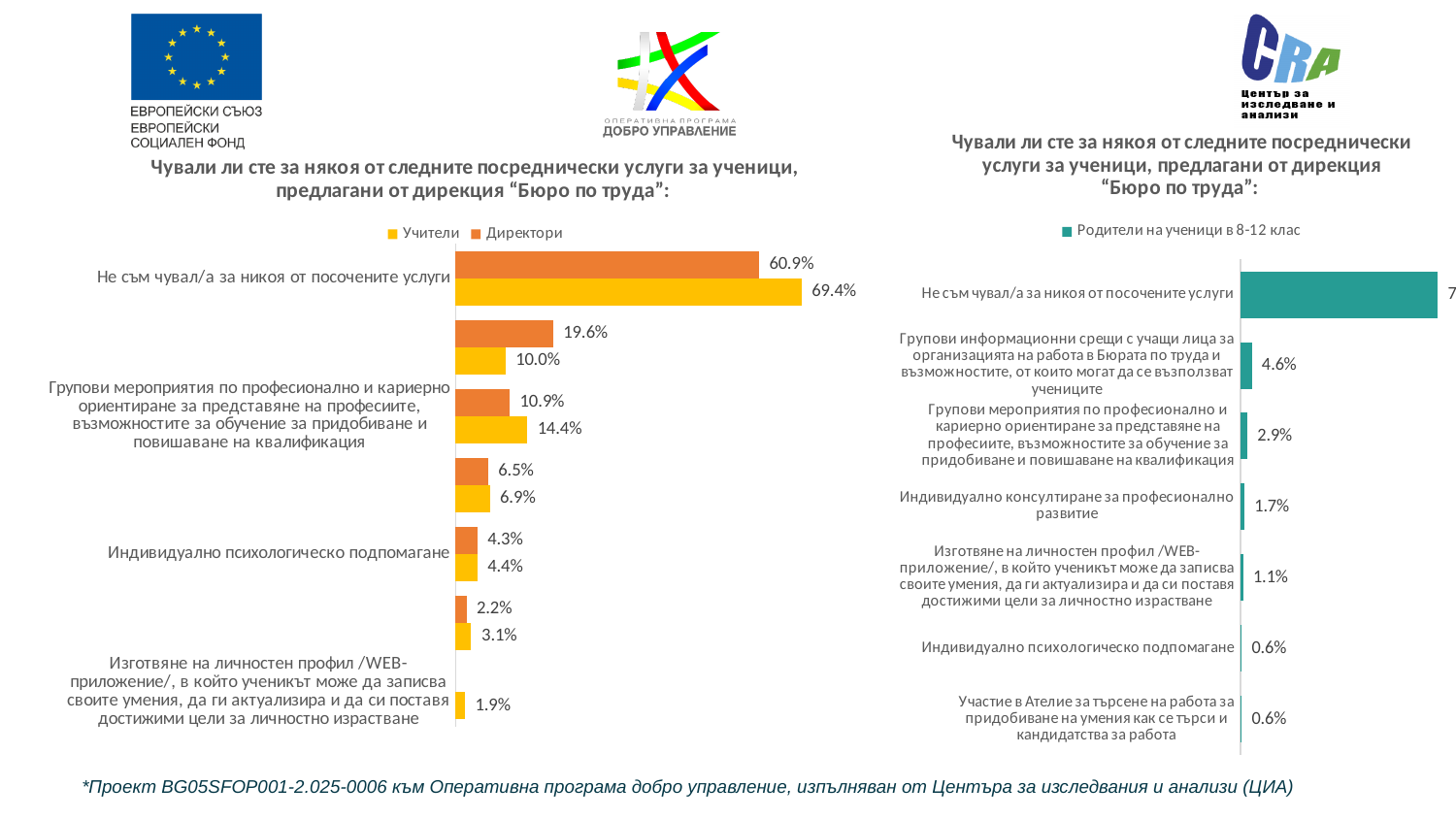
In the right chart, which category has the highest value? Не съм чувал/а за никоя от посочените услуги In the right chart, what is the difference between the values for "Групови информационни срещи" and "Групови мероприятия по професионално и кариерно ориентиране"? 1.7% In the right chart, what is the value for "Групови информационни срещи с учащи лица за организацията на работа в Бюрата по труда и възможностите, от които могат да се възползват учениците"? 4.6% In the left chart, what is the value for Директори for "Не съм чувал/а за никоя от посочените услуги"? 60.9% In the left chart, which series has the larger value for "Не съм чувал/а за никоя от посочените услуги", Учители or Директори? Учители How many series does the legend of the left chart list? 2 In the right chart, what is the value for "Индивидуално консултиране за професионално развитие"? 1.7% In the right chart, what is the value for "Изготвяне на личностен профил /WEB-приложение/"? 1.1% In the left chart, what is the value for Учители for "Не съм чувал/а за никоя от посочените услуги"? 69.4% What kind of chart is the left chart? Bar chart In the left chart, what is the difference between the Учители and Директори values for "Не съм чувал/а за никоя от посочените услуги"? 8.5% How many categories are shown in the right chart? 7